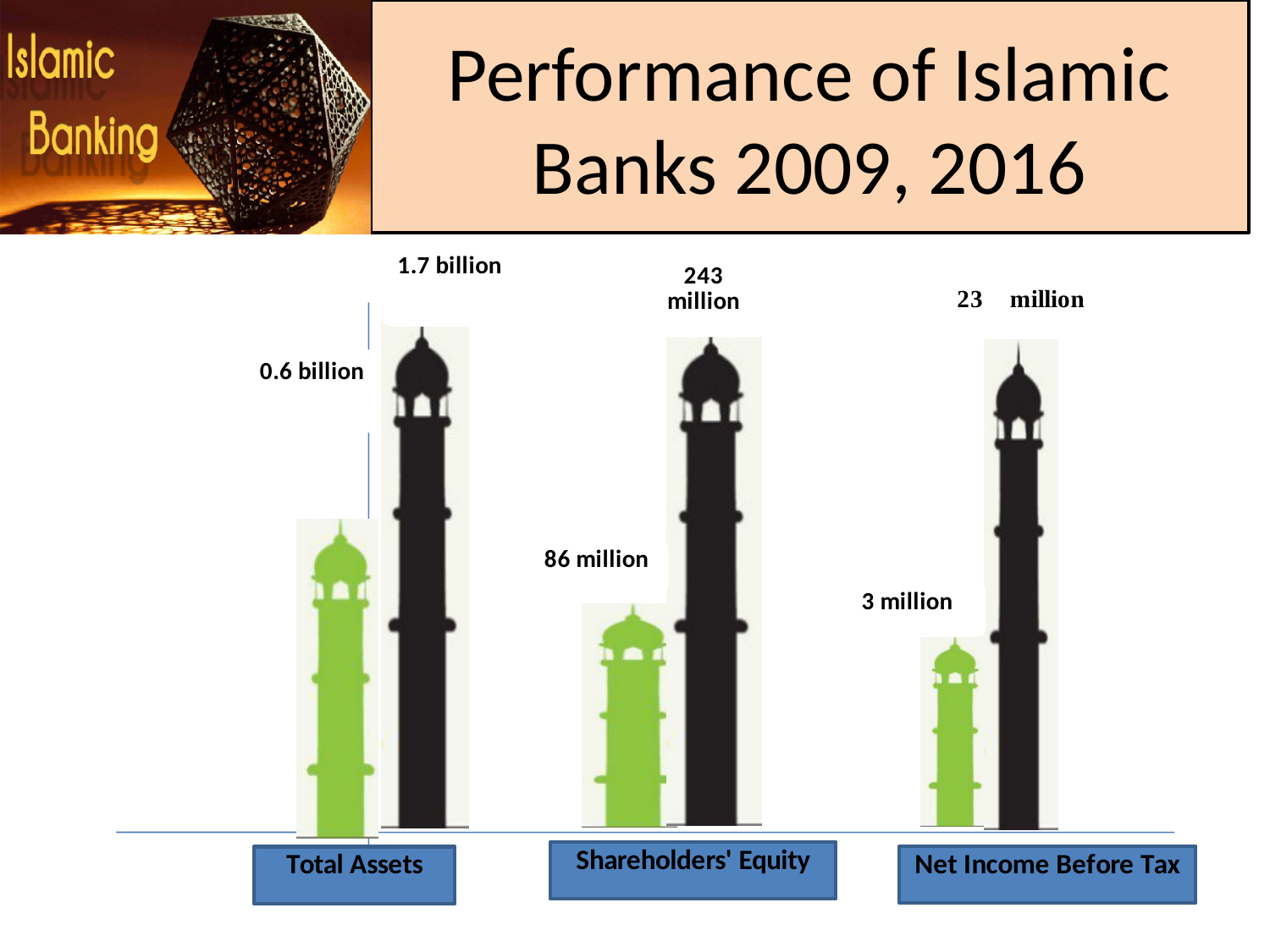
What kind of chart is shown on the slide? bar chart What is the value shown for the shorter (green) bar under Net Income Before Tax? 3 million What is the value shown for the taller (black) bar under Shareholders' Equity? 243 million What is the value shown for the taller (black) bar under Total Assets? 1.7 billion What is the difference between the two values shown for Shareholders' Equity? 157 million What is the difference between the two values shown for Total Assets? 1.1 billion What is the difference between the two values shown for Net Income Before Tax? 20 million How many categories are shown along the bottom of the chart? 3 What is the value shown for the shorter (green) bar under Shareholders' Equity? 86 million Which is larger for Net Income Before Tax, the green bar or the black bar? the black bar What is the value shown for the shorter (green) bar under Total Assets? 0.6 billion What is the value shown for the taller (black) bar under Net Income Before Tax? 23 million